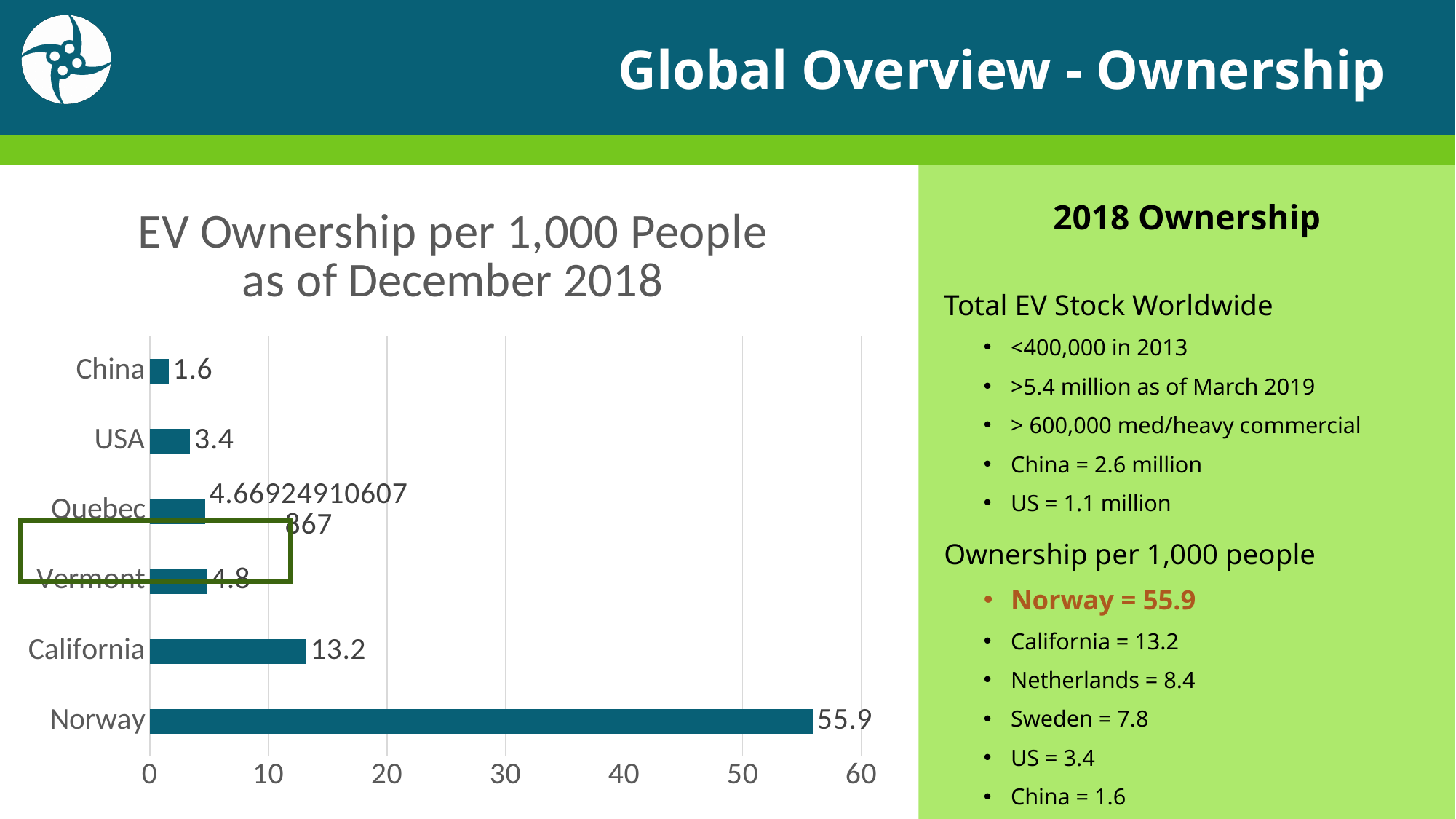
What is the title of the chart? EV Ownership per 1,000 People as of December 2018 What is the EV ownership per 1,000 people for Norway? 55.9 What is the EV ownership per 1,000 people for China? 1.6 What is the EV ownership per 1,000 people for Vermont? 4.8 Which category has the highest EV ownership per 1,000 people? Norway What is the difference between Norway's and California's EV ownership per 1,000 people? 42.7 Which category has the lowest EV ownership per 1,000 people? China Is the value for Quebec greater or less than 10? less How many categories are shown in the chart? 6 Which has a higher EV ownership per 1,000 people, USA or Vermont? Vermont What kind of chart is shown on the slide? Bar chart What is the EV ownership per 1,000 people for California? 13.2